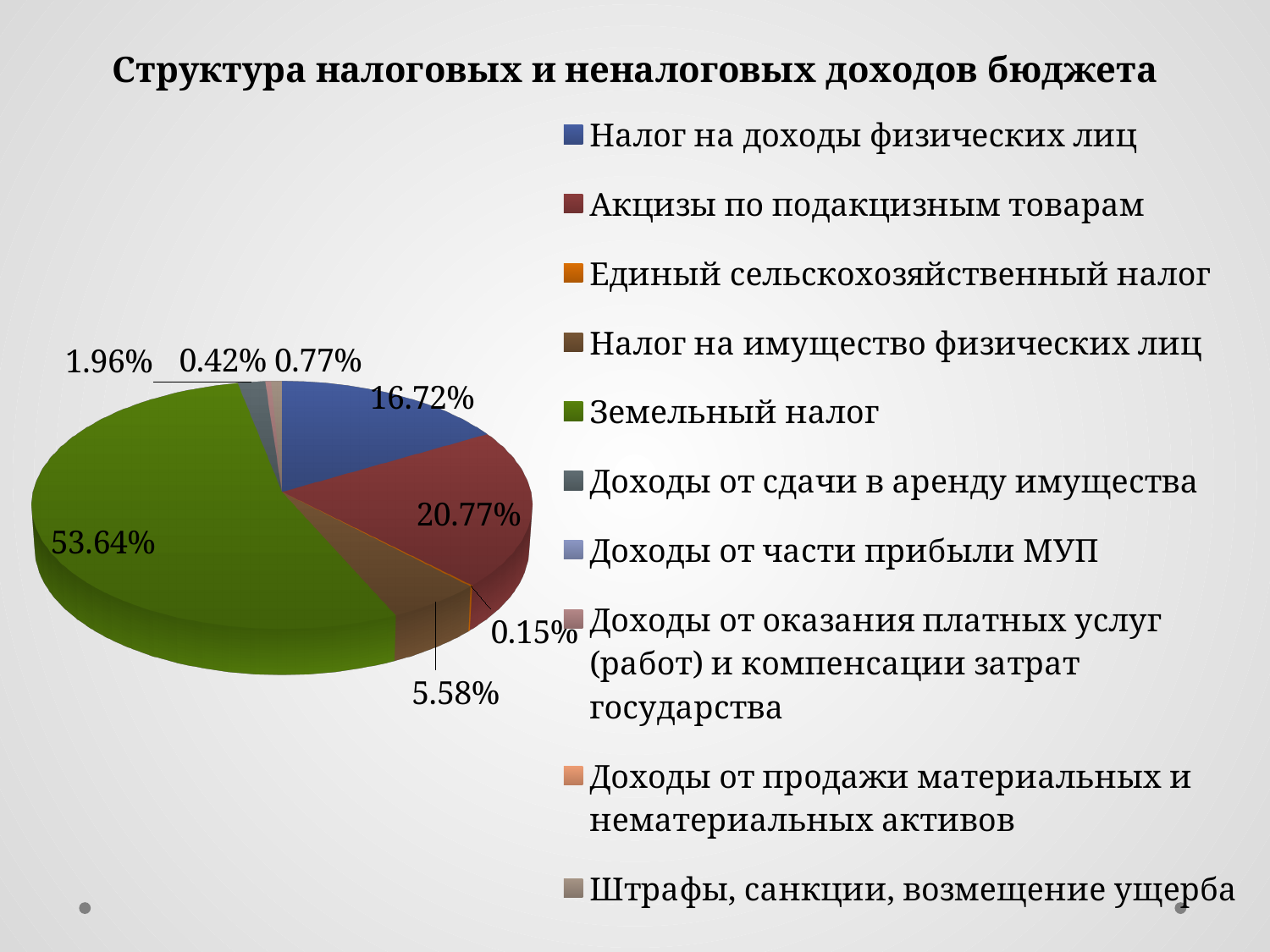
What share of the pie does Земельный налог have? 53.64% What share of the pie does Единый сельскохозяйственный налог have? 0.15% Which category has the largest slice of the pie? Земельный налог Which is larger: the slice for Акцизы по подакцизным товарам or the slice for Налог на доходы физических лиц? Акцизы по подакцизным товарам What kind of chart is shown on the slide? pie chart What is the title of the chart? Структура налоговых и неналоговых доходов бюджета What share of the pie does Налог на доходы физических лиц have? 16.72% What share of the pie does Налог на имущество физических лиц have? 5.58% How many entries does the legend list? 10 What share of the pie does Доходы от сдачи в аренду имущества have? 1.96% What is the difference in percentage points between the slices for Акцизы по подакцизным товарам and Налог на доходы физических лиц? 4.05 What share of the pie does Акцизы по подакцизным товарам have? 20.77%